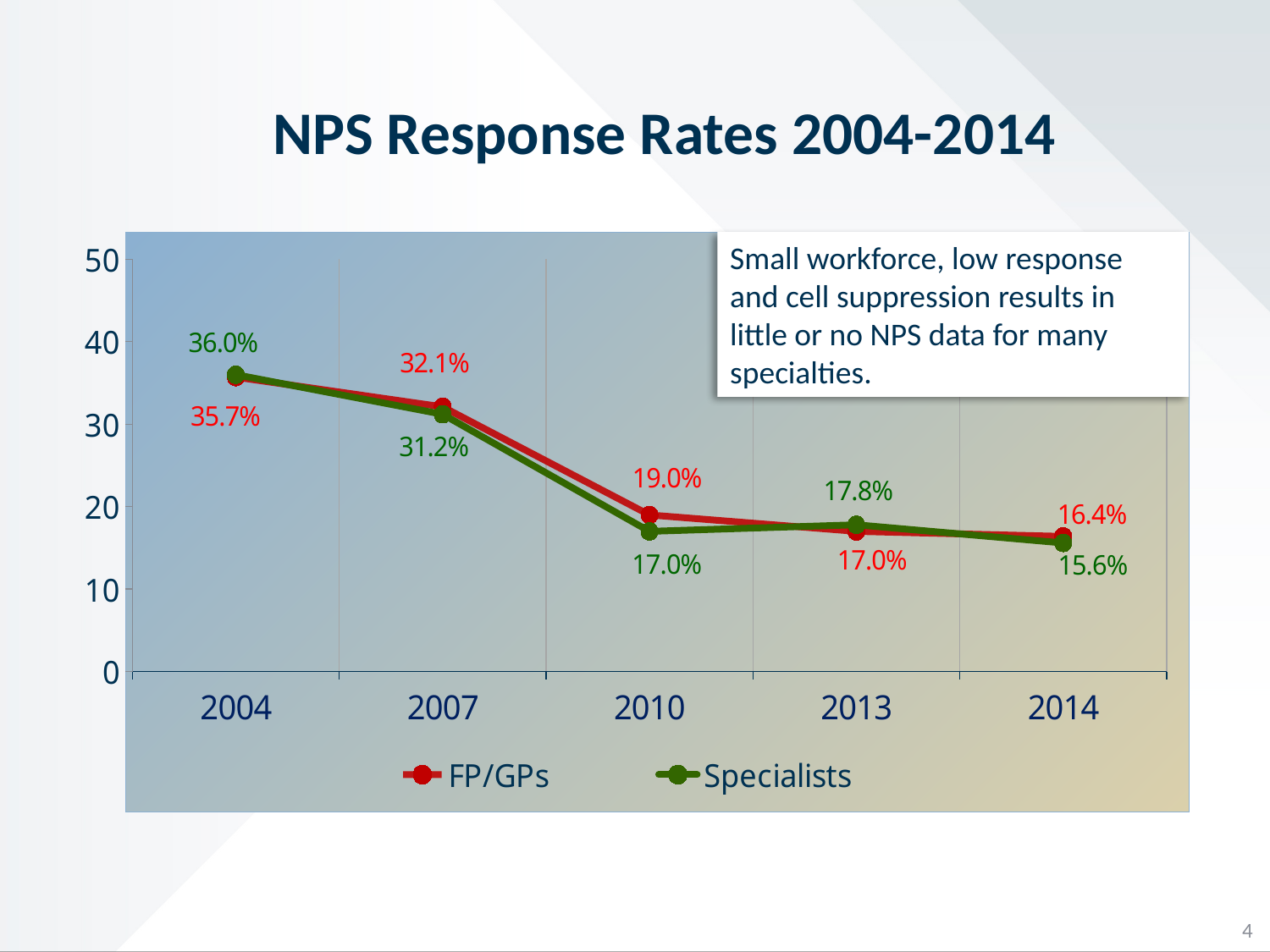
How many years are shown on the x axis? 5 In which year is the Specialists response rate highest? 2004 What kind of chart is shown on the slide? Line chart What is the Specialists response rate in 2014? 15.6% Which series has the higher response rate in 2013, FP/GPs or Specialists? Specialists In which year is the FP/GPs response rate lowest? 2014 What is the Specialists response rate in 2007? 31.2% What is the difference between the FP/GPs and Specialists response rates in 2010? 2.0% What is the FP/GPs response rate in 2010? 19.0% How many series does the legend list? 2 What is the FP/GPs response rate in 2013? 17.0% Do the FP/GPs response rates rise or fall from 2004 to 2014? Fall